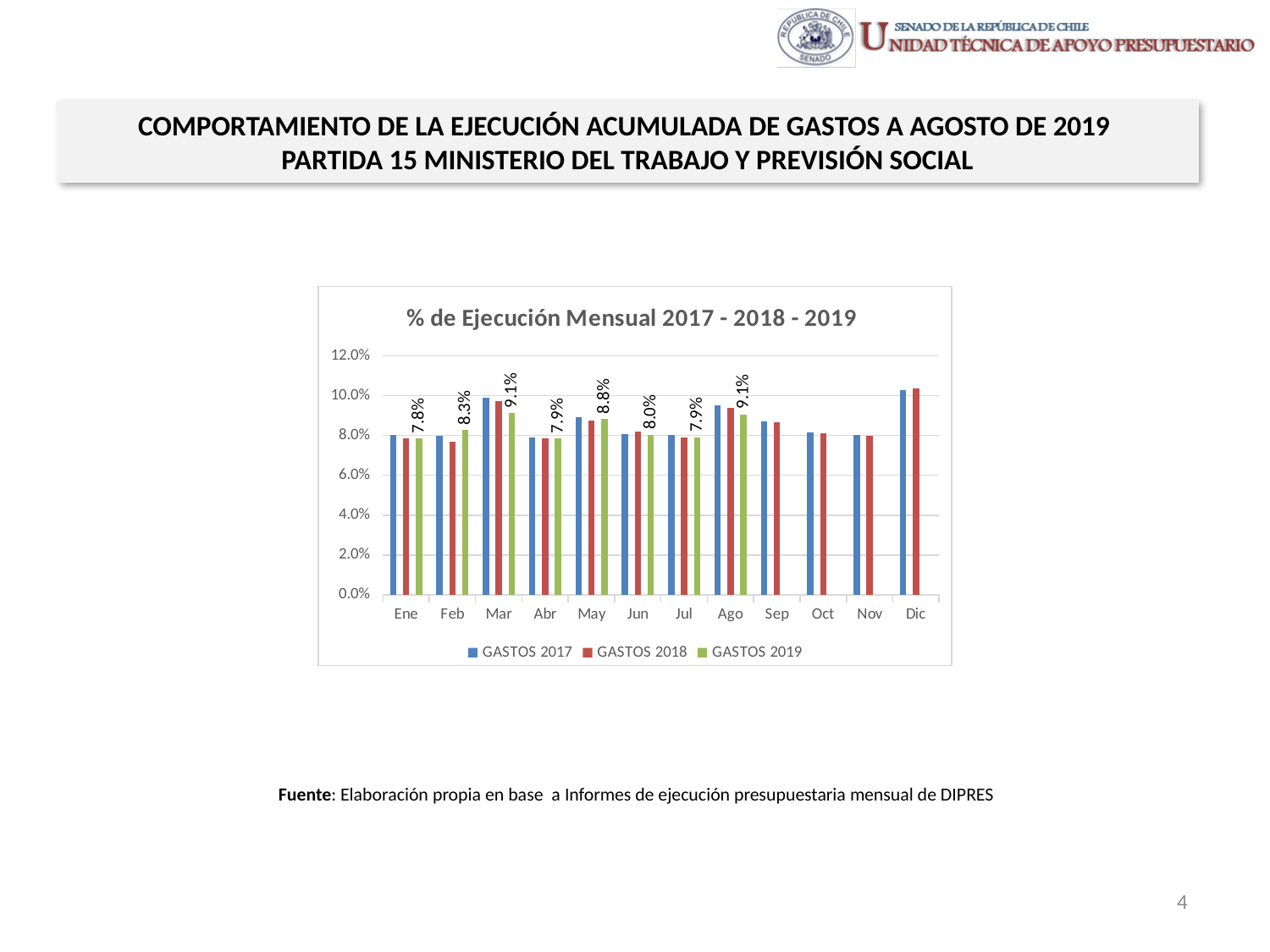
What is the value for GASTOS 2019 in Feb? 8.3% Is the value for GASTOS 2017 in Mar greater or less than 8.0%? greater How many series does the legend list? 3 What is the value for GASTOS 2019 in May? 8.8% What is the value for GASTOS 2019 in Ene? 7.8% How many months are shown on the x axis? 12 Which is larger for GASTOS 2019: Mar or Feb? Mar What is the title of the chart? % de Ejecución Mensual 2017 - 2018 - 2019 What kind of chart is shown? Bar chart Which month has the lowest labelled value for GASTOS 2019? Ene What is the difference between the GASTOS 2019 values for May and Ene? 1.0% What is the value for GASTOS 2019 in Ago? 9.1%